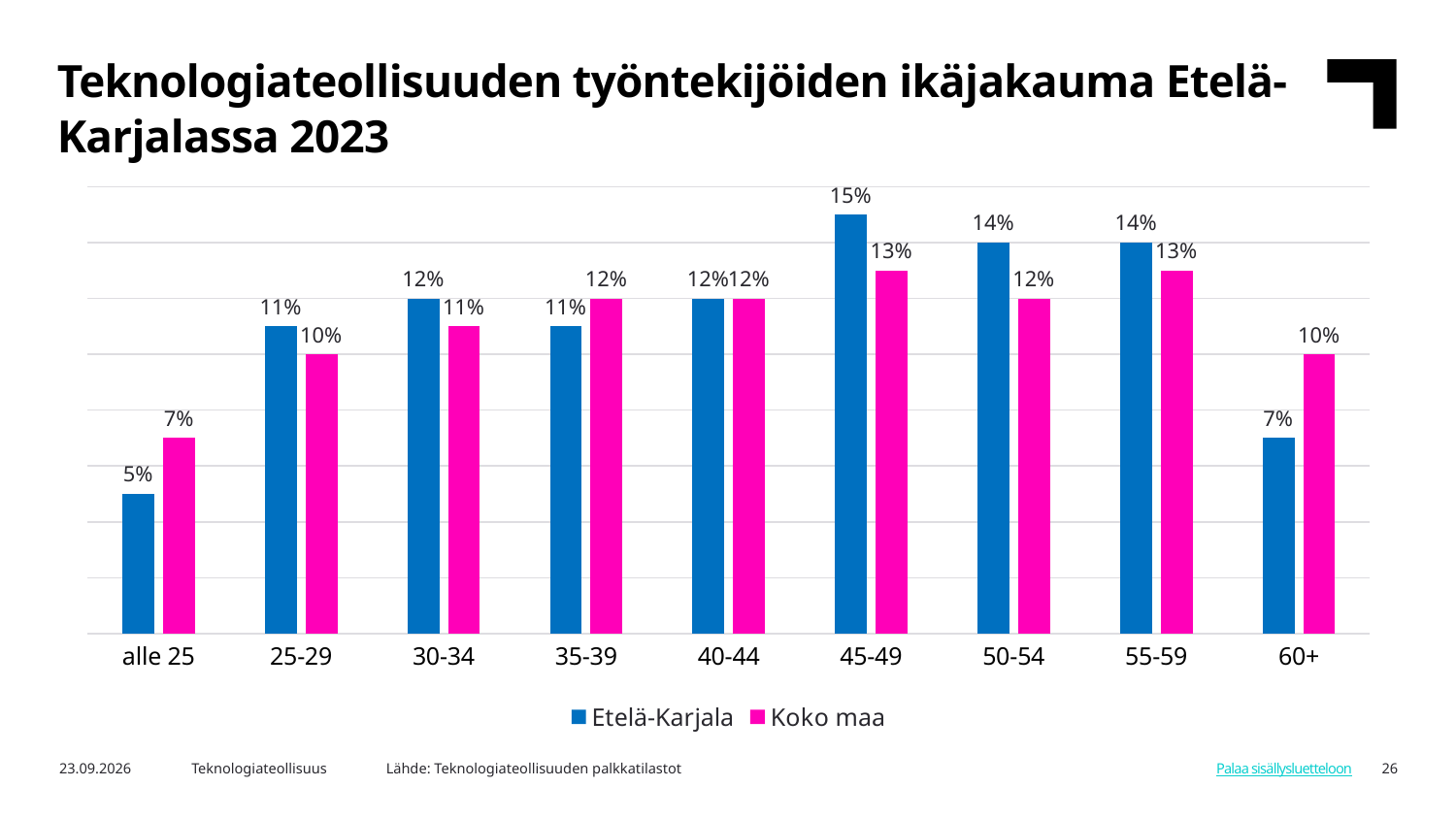
Which age group has the lowest value for Koko maa? alle 25 What is the value for Koko maa in the 25-29 age group? 10% What is the value for Etelä-Karjala in the alle 25 age group? 5% Which series is shown in pink? Koko maa How many age groups are shown on the x axis? 9 What is the value for Etelä-Karjala in the 45-49 age group? 15% What kind of chart is shown on the slide? bar chart Which is larger in the 50-54 age group, Etelä-Karjala or Koko maa? Etelä-Karjala How many series does the legend list? 2 Which age group has the highest value for Etelä-Karjala? 45-49 What is the value for Koko maa in the 60+ age group? 10% What is the difference between Etelä-Karjala and Koko maa in the 60+ age group? 3%